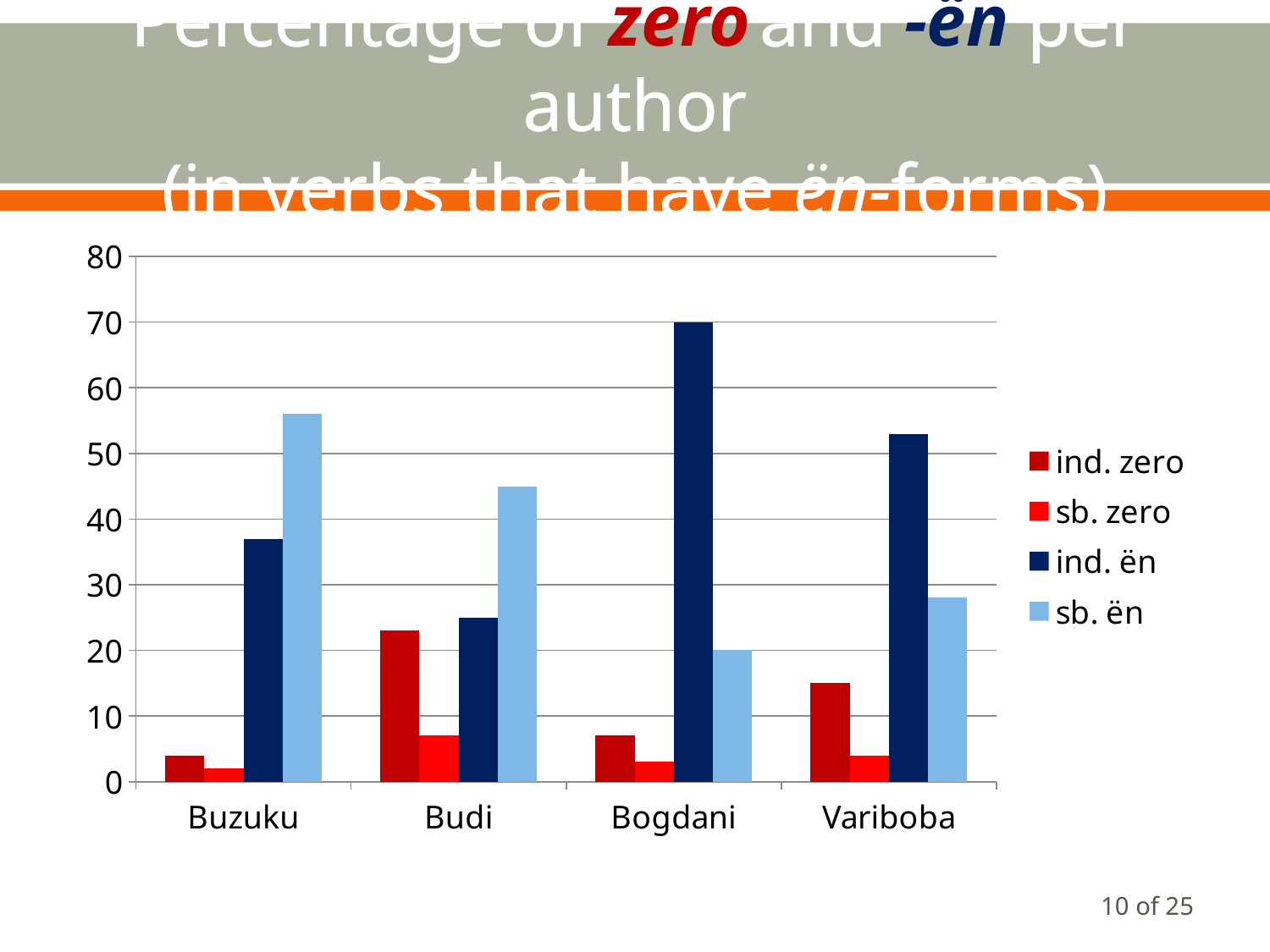
Which author has the highest value for ind. ën? Bogdani Which author has the highest value for ind. zero? Budi For Buzuku, which is larger: ind. ën or sb. ën? sb. ën How many series does the chart's legend list? 4 How many authors are shown on the x axis of the chart? 4 Which author has the lowest value for ind. zero? Buzuku Is the value for ind. ën for Bogdani greater or less than 60? greater Which legend entry is shown in light blue? sb. ën Is the value for sb. ën for Budi greater or less than 40? greater For Variboba, which is larger: ind. ën or sb. ën? ind. ën What kind of chart is shown on the slide? bar chart Which author has the highest value for sb. ën? Buzuku